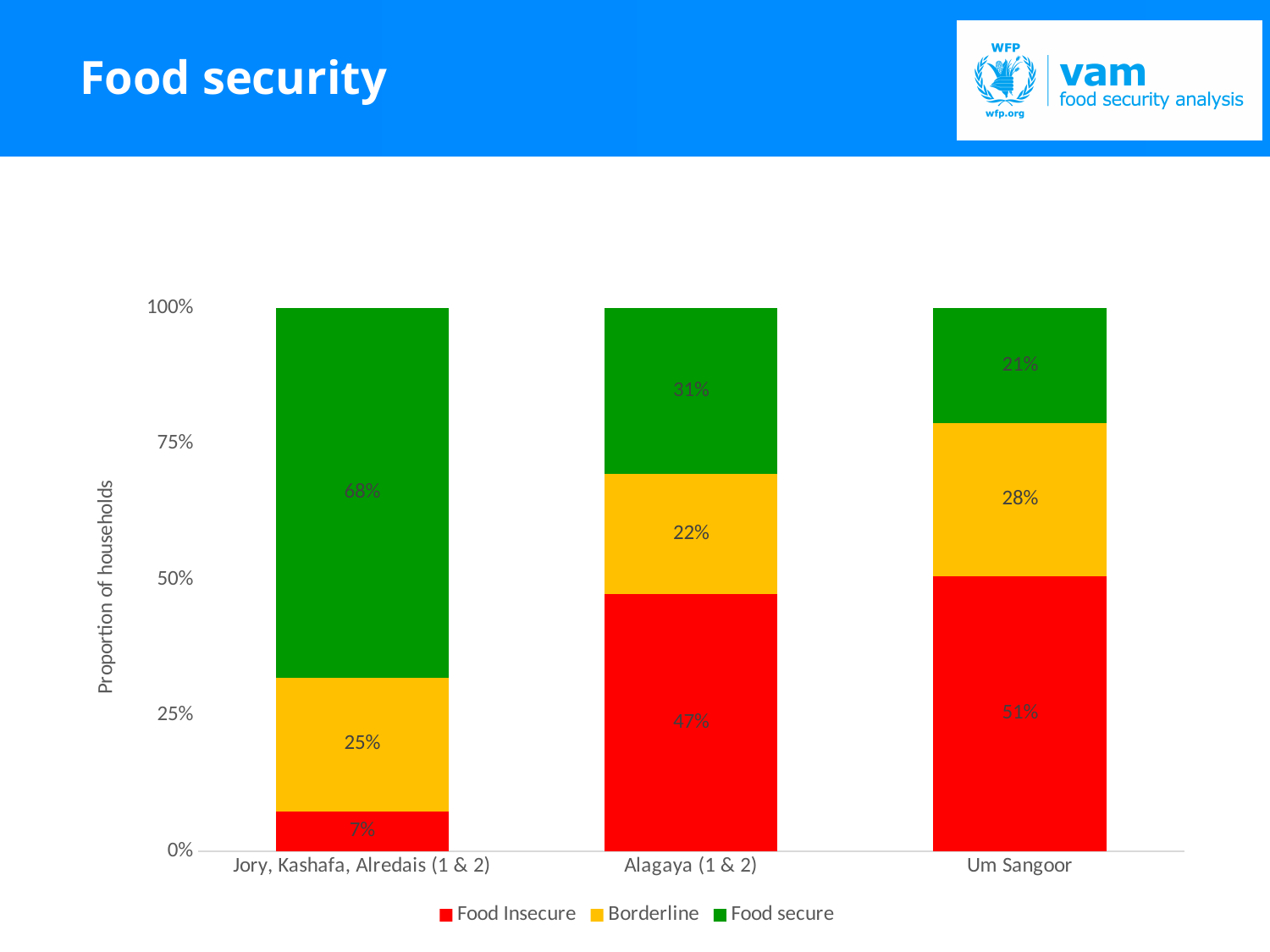
Which location has the lowest Food secure share? Um Sangoor How many locations are shown on the x axis? 3 Which colour represents the Borderline series in the legend? Yellow What is the y-axis label of the chart? Proportion of households What is the Borderline value for Um Sangoor? 28% What is the Food secure value for Jory, Kashafa, Alredais (1 & 2)? 68% What is the Food Insecure value for Alagaya (1 & 2)? 47% How many series does the legend list? 3 Which is larger: the Food secure value for Alagaya (1 & 2) or for Um Sangoor? Alagaya (1 & 2) What is the difference between the Food Insecure values for Um Sangoor and Jory, Kashafa, Alredais (1 & 2)? 44% Which location has the highest Food Insecure share? Um Sangoor What kind of chart is shown on the slide? Stacked bar chart